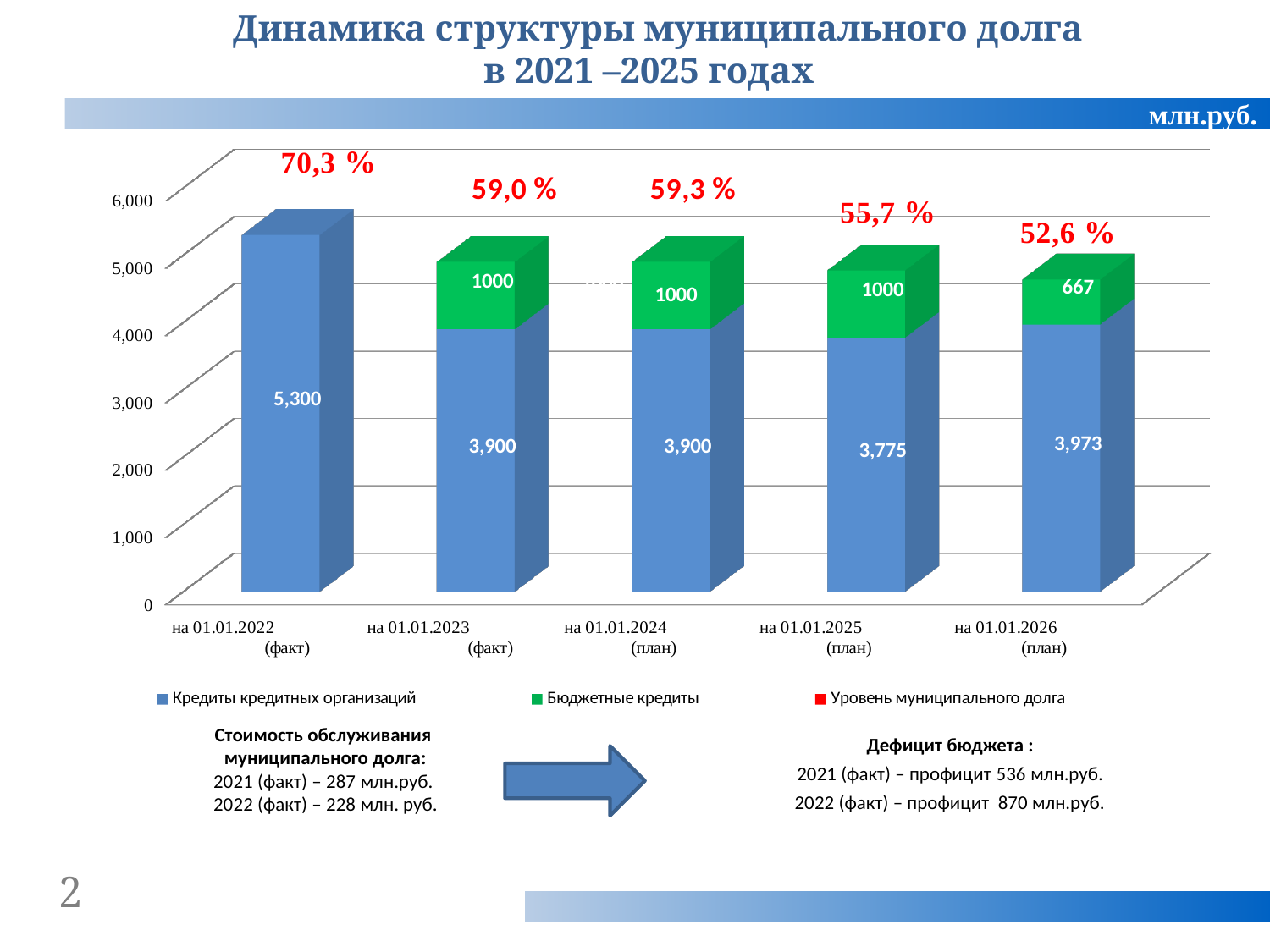
What is the value of Кредиты кредитных организаций for на 01.01.2022 (факт)? 5,300 Which category has the lowest Уровень муниципального долга percentage? на 01.01.2026 (план) What is the Уровень муниципального долга percentage shown for на 01.01.2023 (факт)? 59,0 % How many series does the legend list? 3 What is the value of Бюджетные кредиты for на 01.01.2026 (план)? 667 What is the value of Кредиты кредитных организаций for на 01.01.2025 (план)? 3,775 What is the total of the stacked bar for на 01.01.2026 (план)? 4,640 Which is larger: Кредиты кредитных организаций for на 01.01.2025 (план) or for на 01.01.2026 (план)? на 01.01.2026 (план) Which category has the highest value of Кредиты кредитных организаций? на 01.01.2022 (факт) How many categories are shown on the x axis? 5 What kind of chart is shown on the slide? stacked bar chart What is the difference between Кредиты кредитных организаций for на 01.01.2022 (факт) and на 01.01.2023 (факт)? 1,400